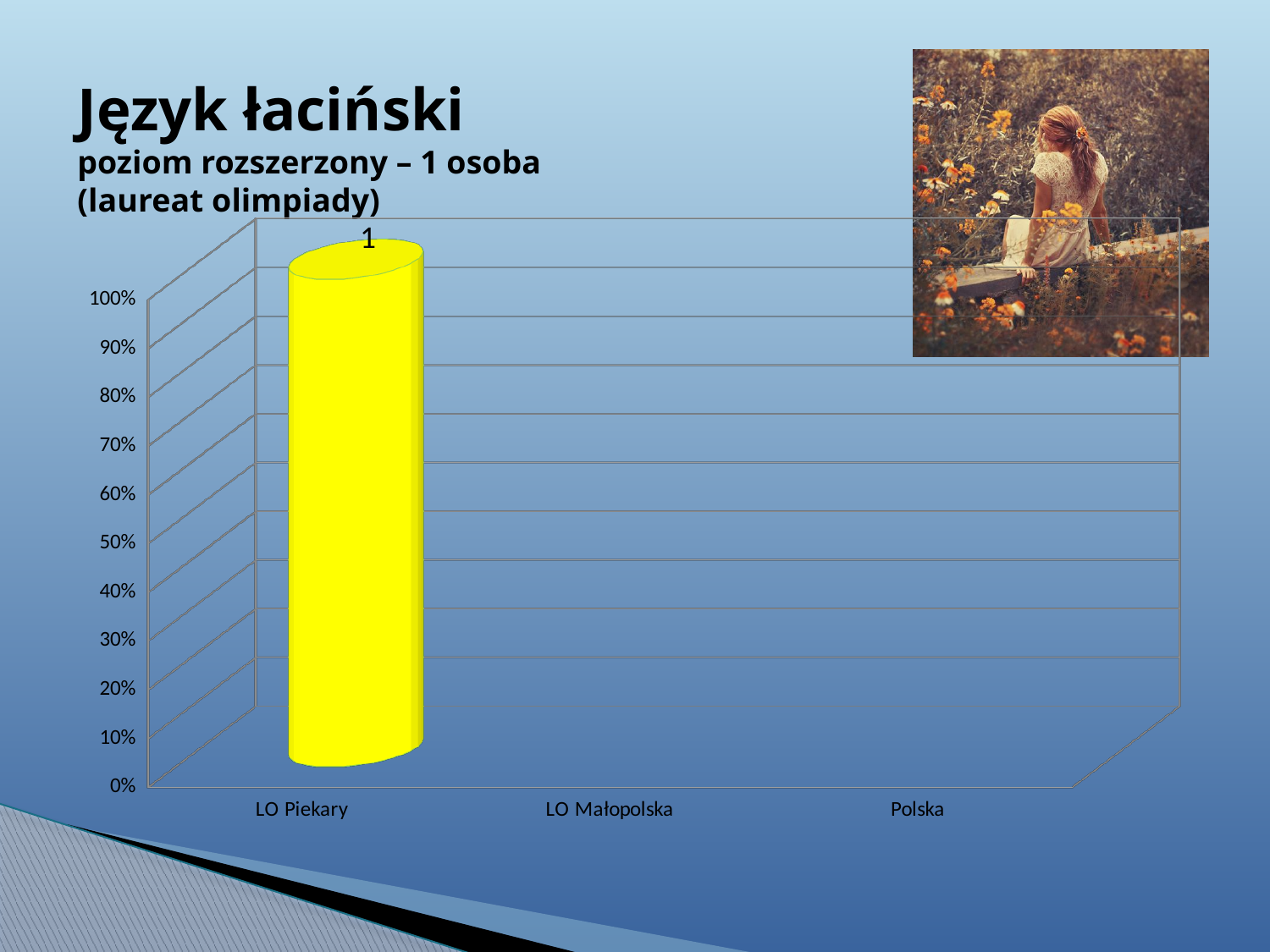
What kind of chart is shown on the slide? bar chart How many categories are shown on the x axis of the chart? 3 Which category has the highest bar in the chart? LO Piekary What colour is the bar for LO Piekary? yellow Is the value for LO Piekary greater or less than 50%? greater What is the label of the last category on the x axis? Polska What data label is printed on the bar for LO Piekary? 1 Is the value for LO Piekary greater or less than 90%? greater What is the highest tick label shown on the vertical axis? 100% What is the label of the first category on the x axis? LO Piekary Which categories on the x axis have no visible bar? LO Małopolska and Polska